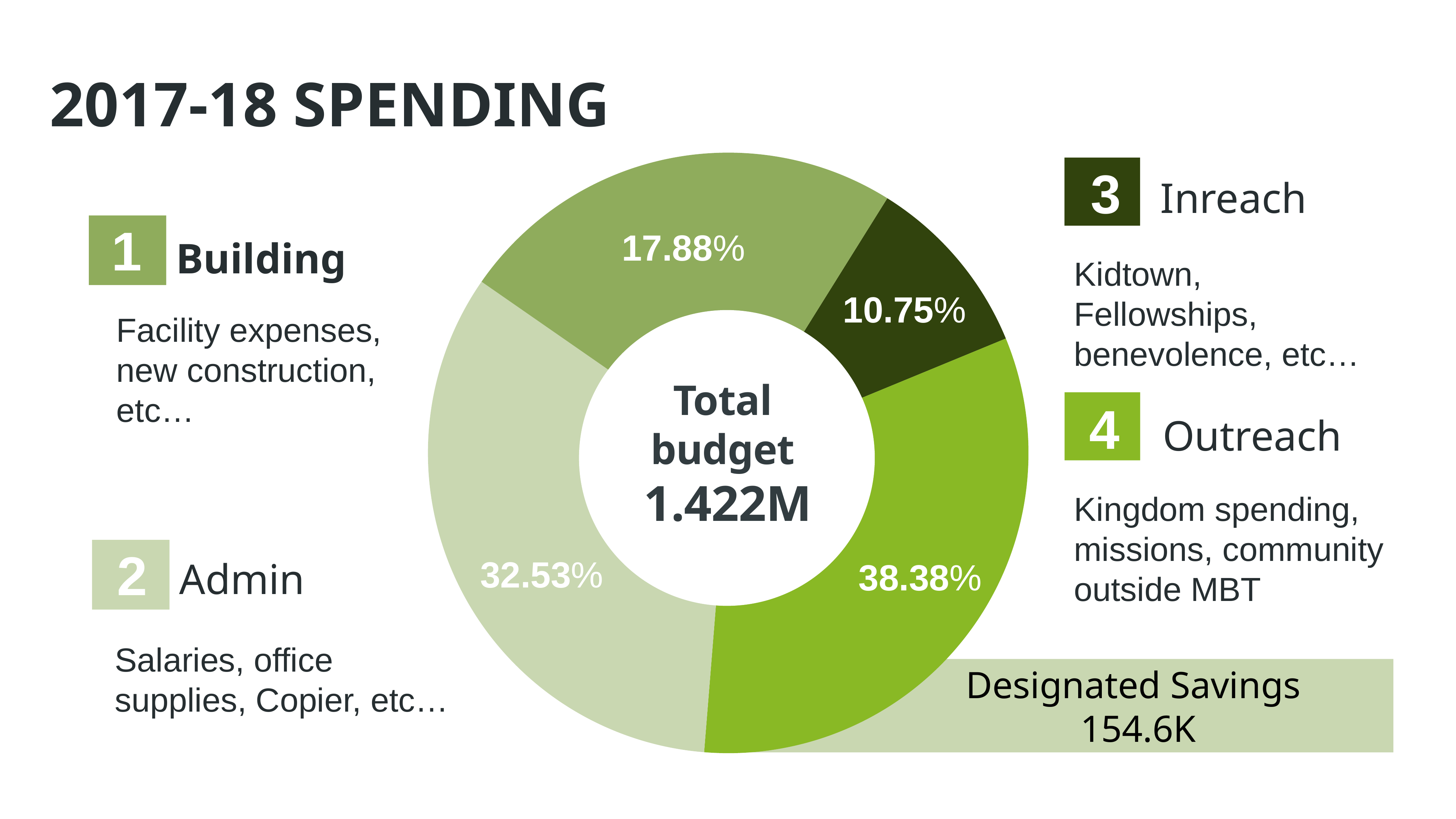
What total budget is shown in the centre of the chart? 1.422M What percentage of spending goes to Outreach? 38.38% What percentage of spending goes to Inreach? 10.75% Which category has the smallest share of spending? Inreach Which category has the largest share of spending? Outreach Which is larger, the share for Building or the share for Inreach? Building What is the difference in percentage points between Outreach and Admin? 5.85 What percentage of spending goes to Admin? 32.53% What is the title of the slide containing the chart? 2017-18 SPENDING What percentage of spending goes to Building? 17.88% What kind of chart is shown on the slide? Donut (pie) chart How many categories are shown in the chart? 4